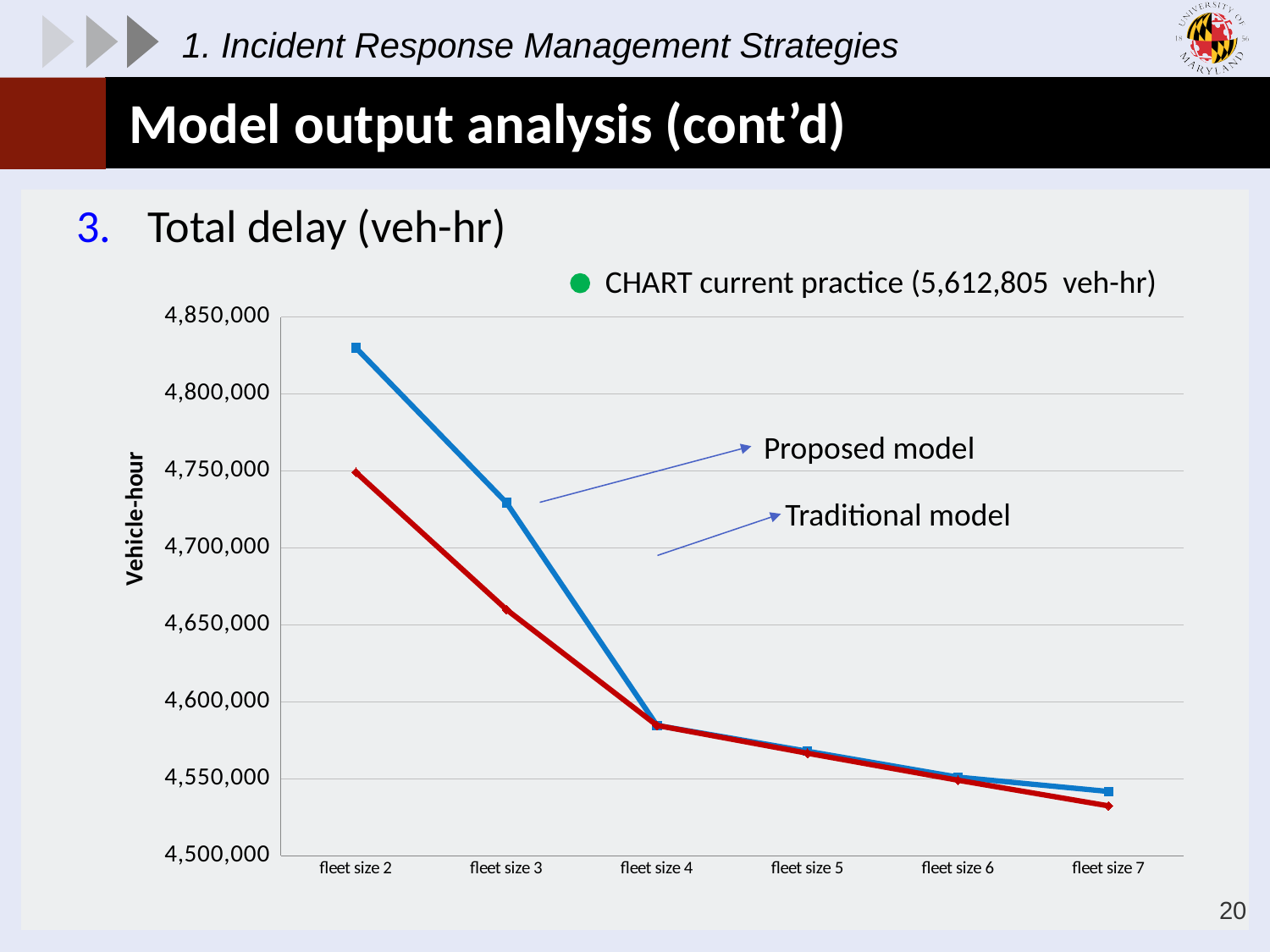
Is the value for the Traditional model at fleet size 3 greater or less than 4,700,000? less How many series (lines) are plotted in the chart? 2 How many fleet size categories are plotted on the x axis? 6 Is the value for the Traditional model at fleet size 7 greater or less than 4,550,000? less Do the values for the Proposed model rise or fall as fleet size increases from 2 to 7? fall At fleet size 2, which model has the higher total delay, the Proposed model or the Traditional model? Proposed model At which fleet size does the Traditional model have its lowest total delay? fleet size 7 Is the value for the Proposed model at fleet size 2 greater or less than 4,800,000? greater What kind of chart is shown on the slide? line chart At which fleet size does the Proposed model have its highest total delay? fleet size 2